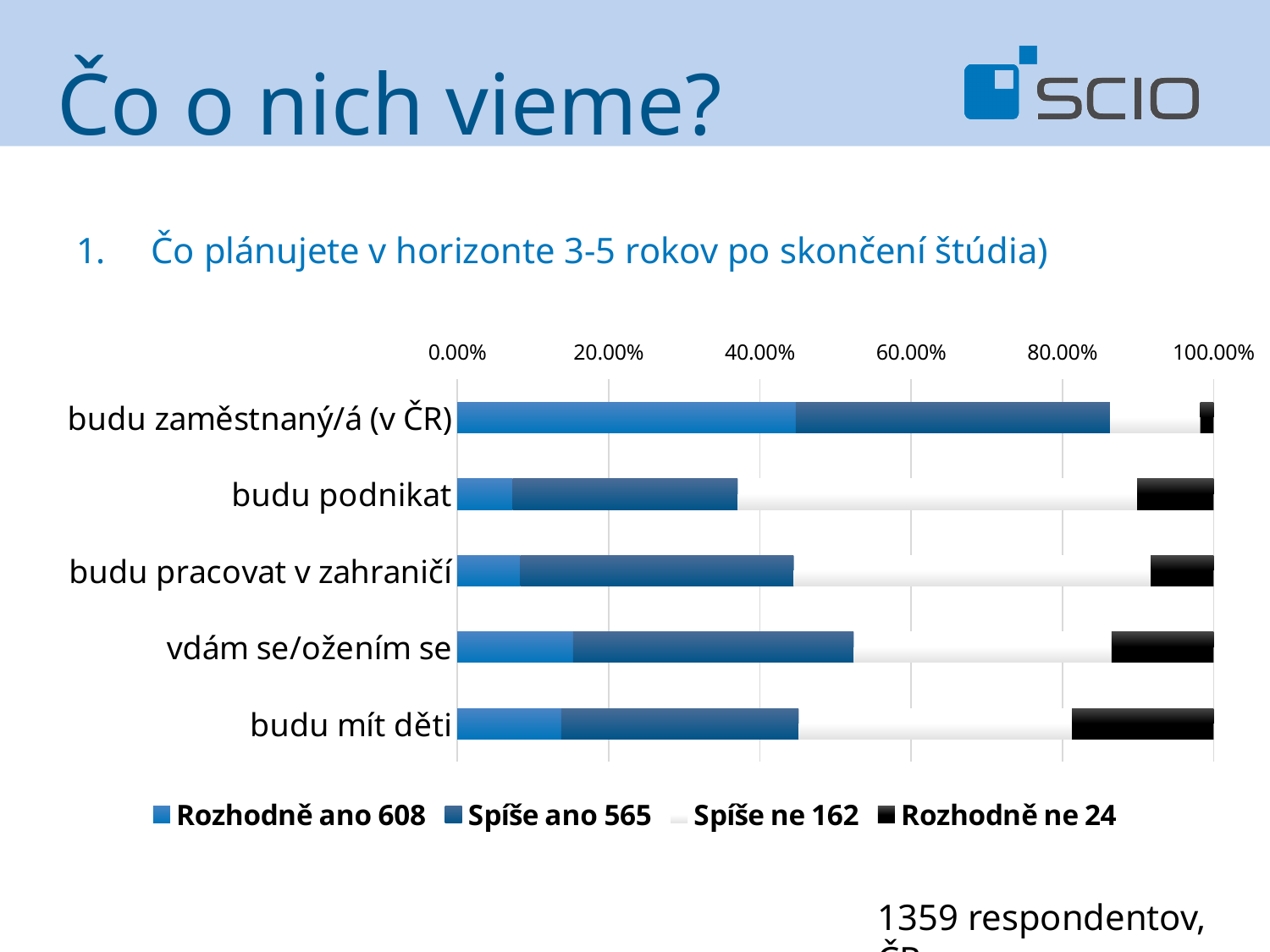
Which category has the largest 'Rozhodně ano' segment? budu zaměstnaný/á (v ČR) Which category has the largest 'Rozhodně ne' segment? budu mít děti What is the highest value shown on the horizontal axis? 100.00% How many series does the legend list? 4 How many categories are plotted on the chart? 5 Is the 'Rozhodně ano' value for 'budu zaměstnaný/á (v ČR)' greater or less than 40.00%? greater What kind of chart is shown on the slide? Stacked bar chart Is the 'Rozhodně ano' value for 'budu podnikat' greater or less than 20.00%? less What number is shown next to 'Rozhodně ano' in the legend? 608 Which has a larger 'Spíše ne' segment: 'budu podnikat' or 'budu zaměstnaný/á (v ČR)'? budu podnikat Which has a larger 'Rozhodně ano' segment: 'vdám se/ožením se' or 'budu podnikat'? vdám se/ožením se Which category has the smallest 'Rozhodně ne' segment? budu zaměstnaný/á (v ČR)